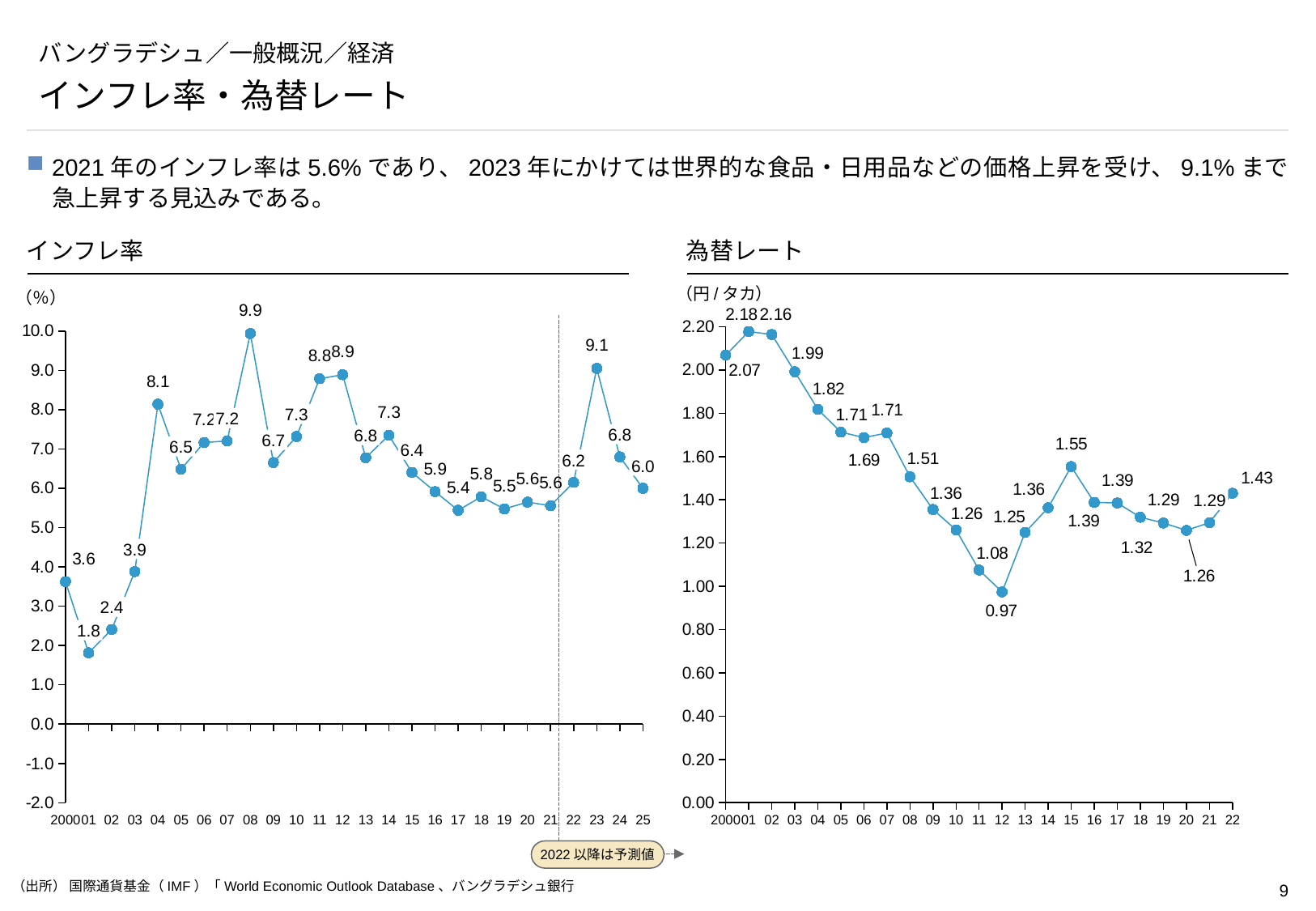
In the 為替レート chart, what is the exchange rate for 2012? 0.97 In the インフレ率 chart, which year has the highest inflation rate? 2008 In the 為替レート chart, what is the difference between the 2001 value and the 2012 value? 1.21 In the インフレ率 chart, which year has the lowest inflation rate? 2001 In the インフレ率 chart, what is the difference between the 2023 value and the 2021 value? 3.5 In the インフレ率 chart, what is the inflation rate for 2023? 9.1 What type of chart is the インフレ率 chart? Line chart In the 為替レート chart, which year has the highest exchange rate? 2001 In the 為替レート chart, what is the exchange rate for 2022? 1.43 In the インフレ率 chart, which is larger, the value for 2004 or the value for 2011? 2011 How many data points are plotted in the 為替レート chart? 23 In the インフレ率 chart, what is the inflation rate for 2008? 9.9